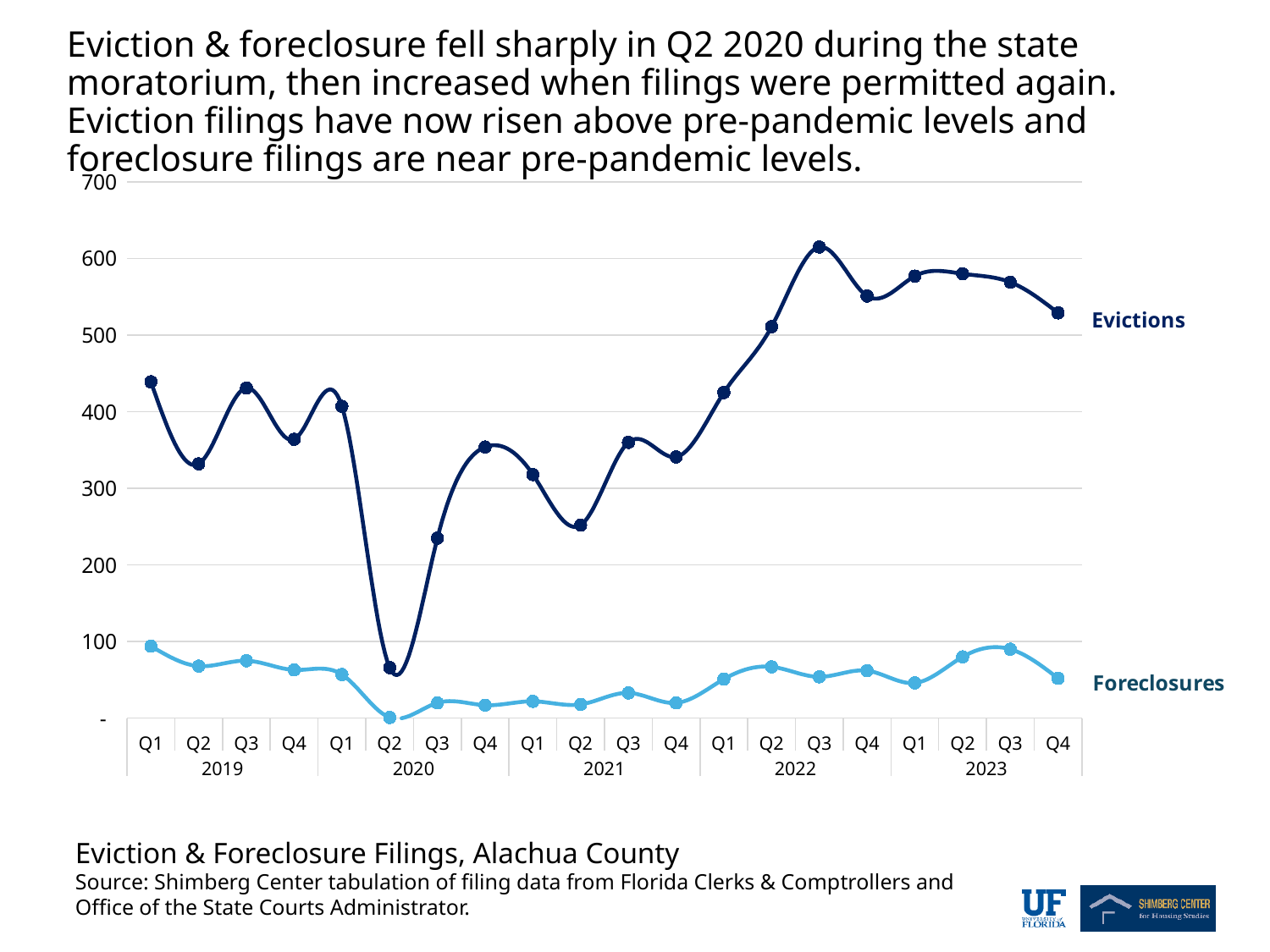
Which is larger, Evictions in Q1 2019 or Evictions in Q2 2019? Q1 2019 In which quarter do Evictions reach their highest value? Q3 2022 Is the value for Evictions in Q2 2020 greater or less than 100? less What kind of chart is shown on the slide? line chart Which series is drawn in the lighter blue line? Foreclosures In which quarter do Evictions reach their lowest value? Q2 2020 How many series are plotted on the chart? 2 Is the value for Evictions in Q3 2022 greater or less than 600? greater In which quarter do Foreclosures reach their lowest value? Q2 2020 How many quarterly data points does each line have? 20 Do Evictions rise or fall from Q2 2020 to Q3 2022? rise